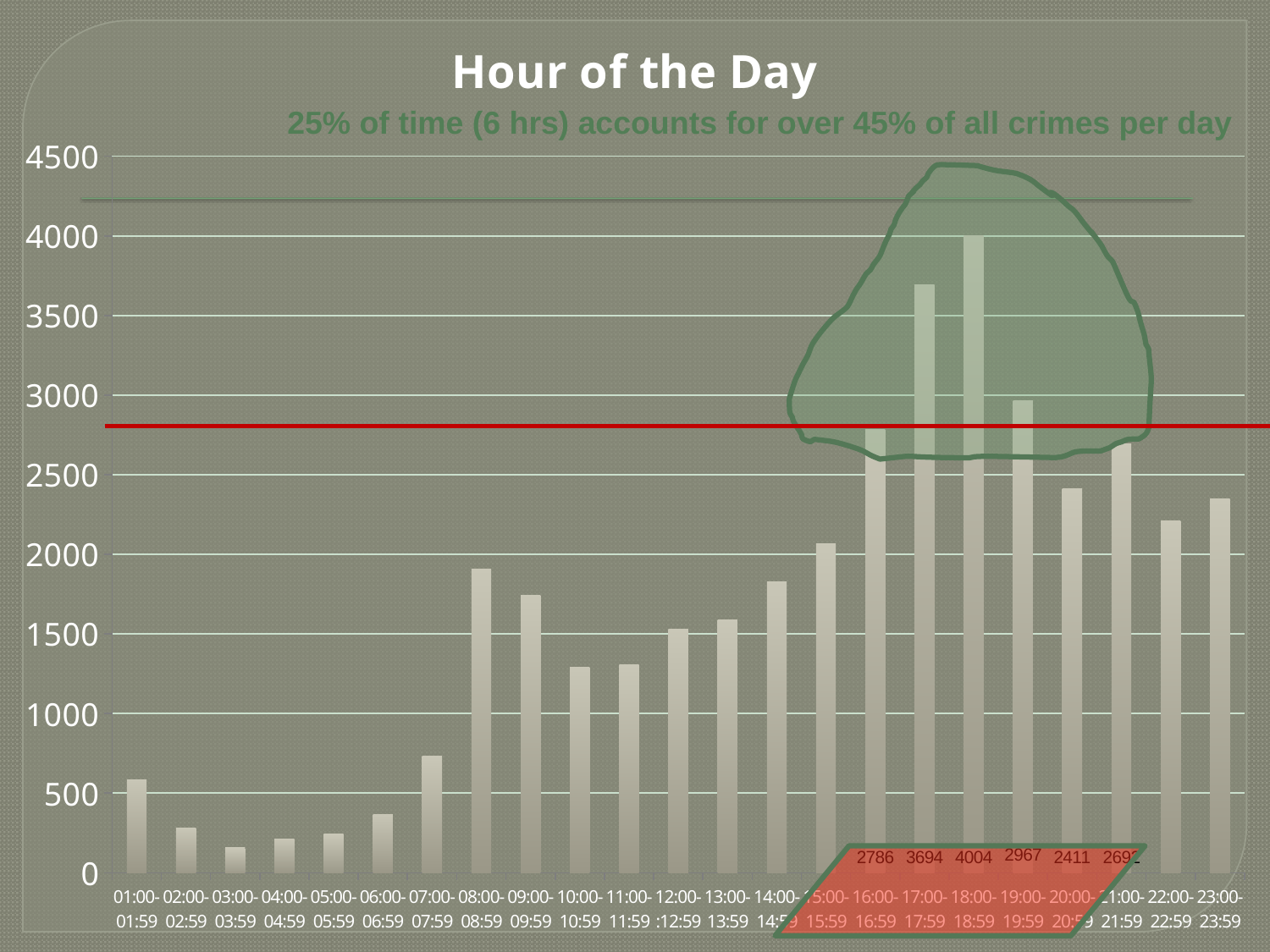
What is the value for 20:00-20:59? 2411 Do the values rise or fall from 14:00-14:59 to 18:00-18:59? rise Which hour has the highest value? 18:00-18:59 What is the value for 17:00-17:59? 3694 Which hour has the lowest value? 03:00-03:59 What type of chart is shown on the slide? bar chart Which is larger, the value for 16:00-16:59 or the value for 19:00-19:59? 19:00-19:59 What is the value for 18:00-18:59? 4004 How many hourly categories are plotted on the x axis? 23 What is the difference between the values for 18:00-18:59 and 17:00-17:59? 310 Is the value for 08:00-08:59 greater or less than 2000? less What is the title of the chart? Hour of the Day